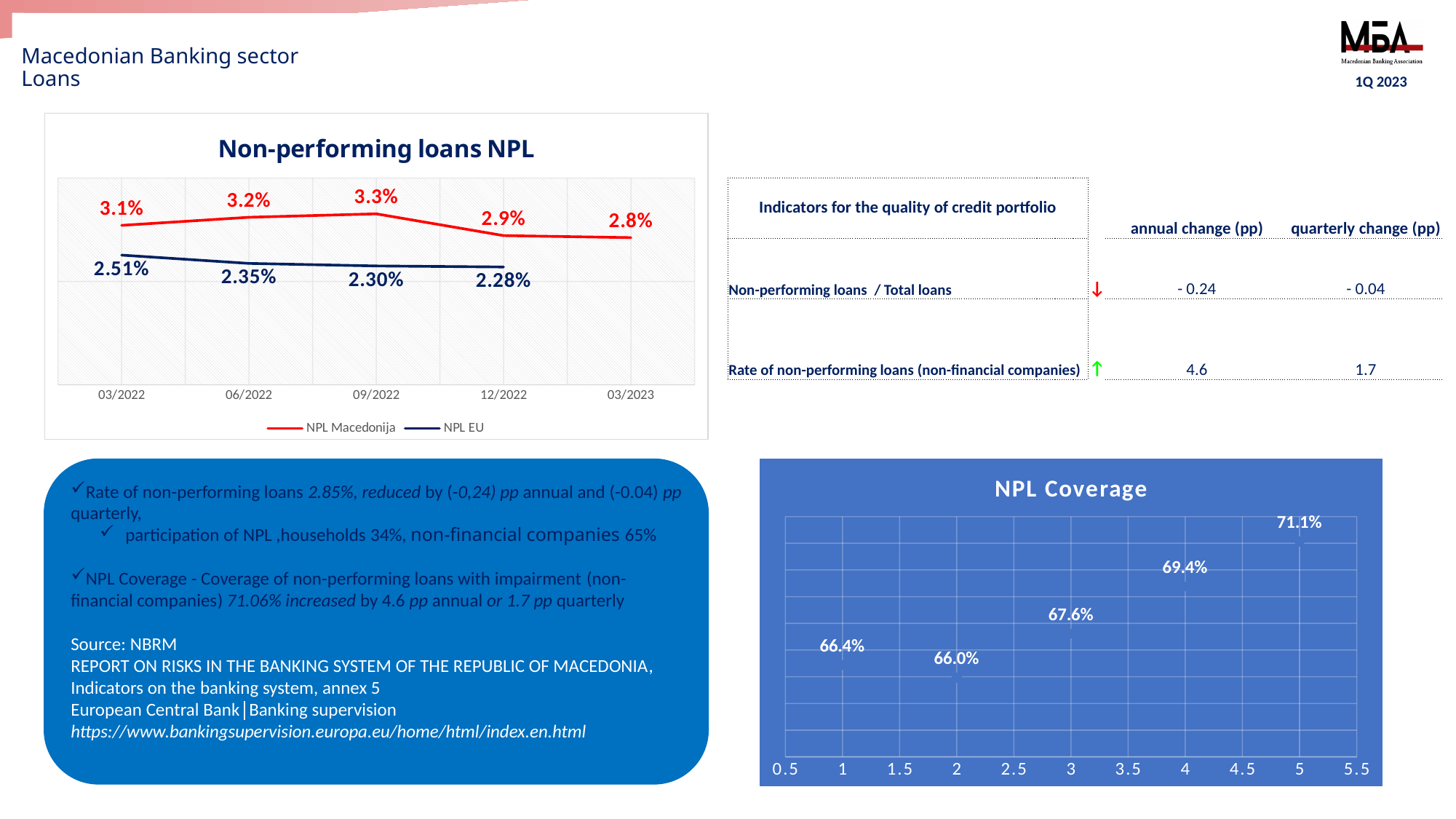
How many series does the legend of the 'Non-performing loans NPL' chart list? 2 In the 'Non-performing loans NPL' chart, what is the value of NPL Macedonija for 09/2022? 3.3% In the 'Non-performing loans NPL' chart, what is the difference between NPL Macedonija and NPL EU in 12/2022? 0.62 percentage points In the 'Non-performing loans NPL' chart, which series is higher in 06/2022, NPL Macedonija or NPL EU? NPL Macedonija What kind of chart is the 'Non-performing loans NPL' chart? Line chart In the 'NPL Coverage' chart, what is the lowest value shown? 66.0% In the 'Non-performing loans NPL' chart, what is the value of NPL EU for 03/2022? 2.51% In the 'Non-performing loans NPL' chart, in which period is NPL EU lowest? 12/2022 In the 'Non-performing loans NPL' chart, does NPL EU rise or fall from 03/2022 to 12/2022? Fall In the 'Non-performing loans NPL' chart, what is the value of NPL Macedonija for 03/2023? 2.8% In the 'NPL Coverage' chart, what is the highest value shown? 71.1% In the 'Non-performing loans NPL' chart, in which period is NPL Macedonija highest? 09/2022